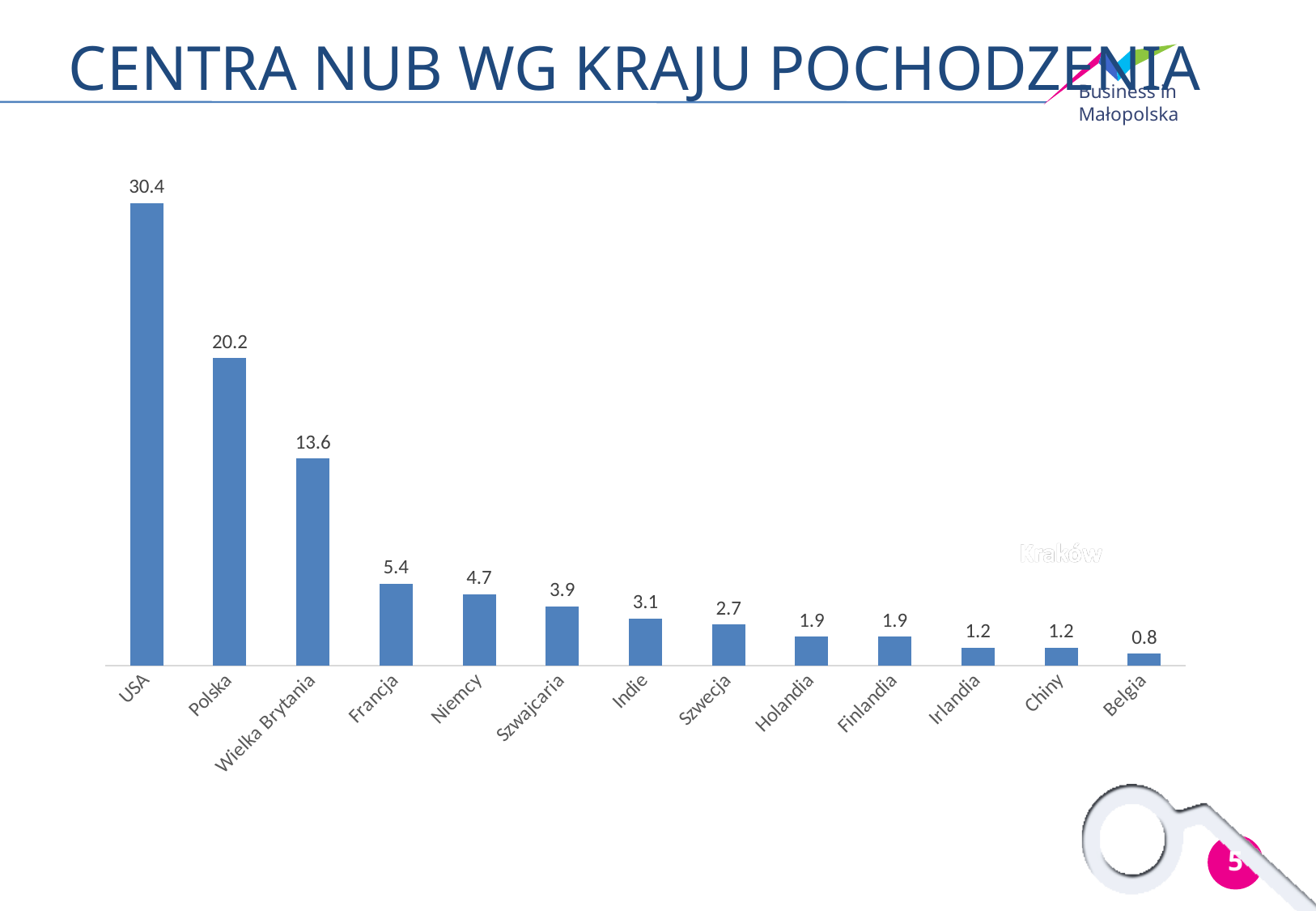
How many countries are shown on the chart? 13 What is the title of the slide? CENTRA NUB WG KRAJU POCHODZENIA What is the value for Szwajcaria? 3.9 Which country has the lowest value? Belgia What is the difference between the values for USA and Polska? 10.2 What is the value for USA? 30.4 What kind of chart is shown on the slide? Bar chart Which country has the highest value? USA What is the value for Wielka Brytania? 13.6 Do the values rise or fall from left to right along the x axis? Fall Which is larger, the value for Indie or the value for Szwecja? Indie What is the difference between the values for Francja and Niemcy? 0.7